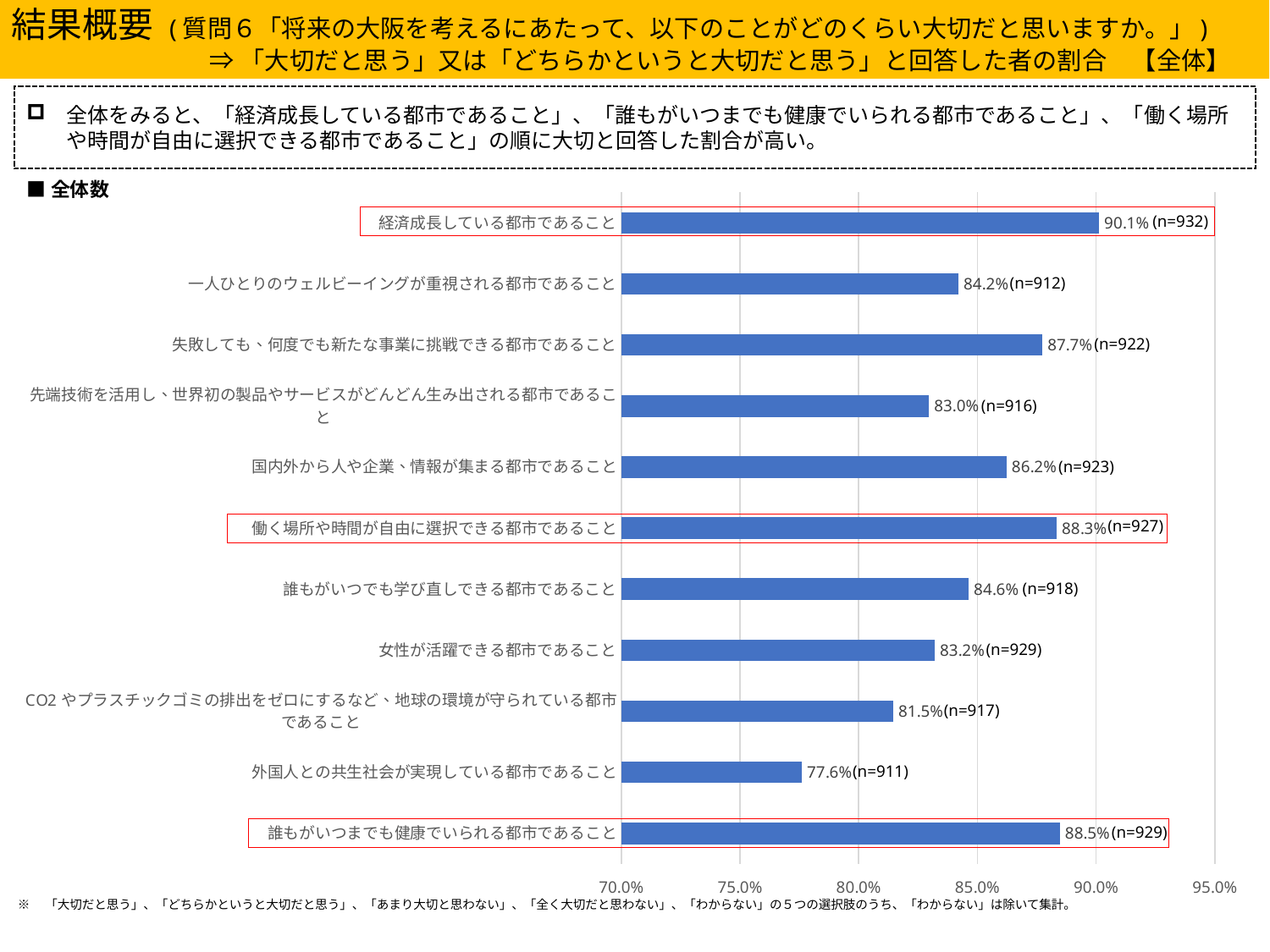
What is the sample size (n) shown for 働く場所や時間が自由に選択できる都市であること? n=927 Which has a higher percentage: 国内外から人や企業、情報が集まる都市であること or 先端技術を活用し、世界初の製品やサービスがどんどん生み出される都市であること? 国内外から人や企業、情報が集まる都市であること Which category has the lowest percentage? 外国人との共生社会が実現している都市であること Is the value for 外国人との共生社会が実現している都市であること greater or less than 80.0%? less What is the value for 外国人との共生社会が実現している都市であること? 77.6% What percentage is shown for 女性が活躍できる都市であること? 83.2% What is the maximum value shown on the horizontal axis? 95.0% How many categories are plotted in the chart? 11 What is the difference in percentage points between 経済成長している都市であること and 外国人との共生社会が実現している都市であること? 12.5 percentage points What kind of chart is shown on the slide? Bar chart Which category has the highest percentage? 経済成長している都市であること What percentage is shown for 経済成長している都市であること? 90.1%